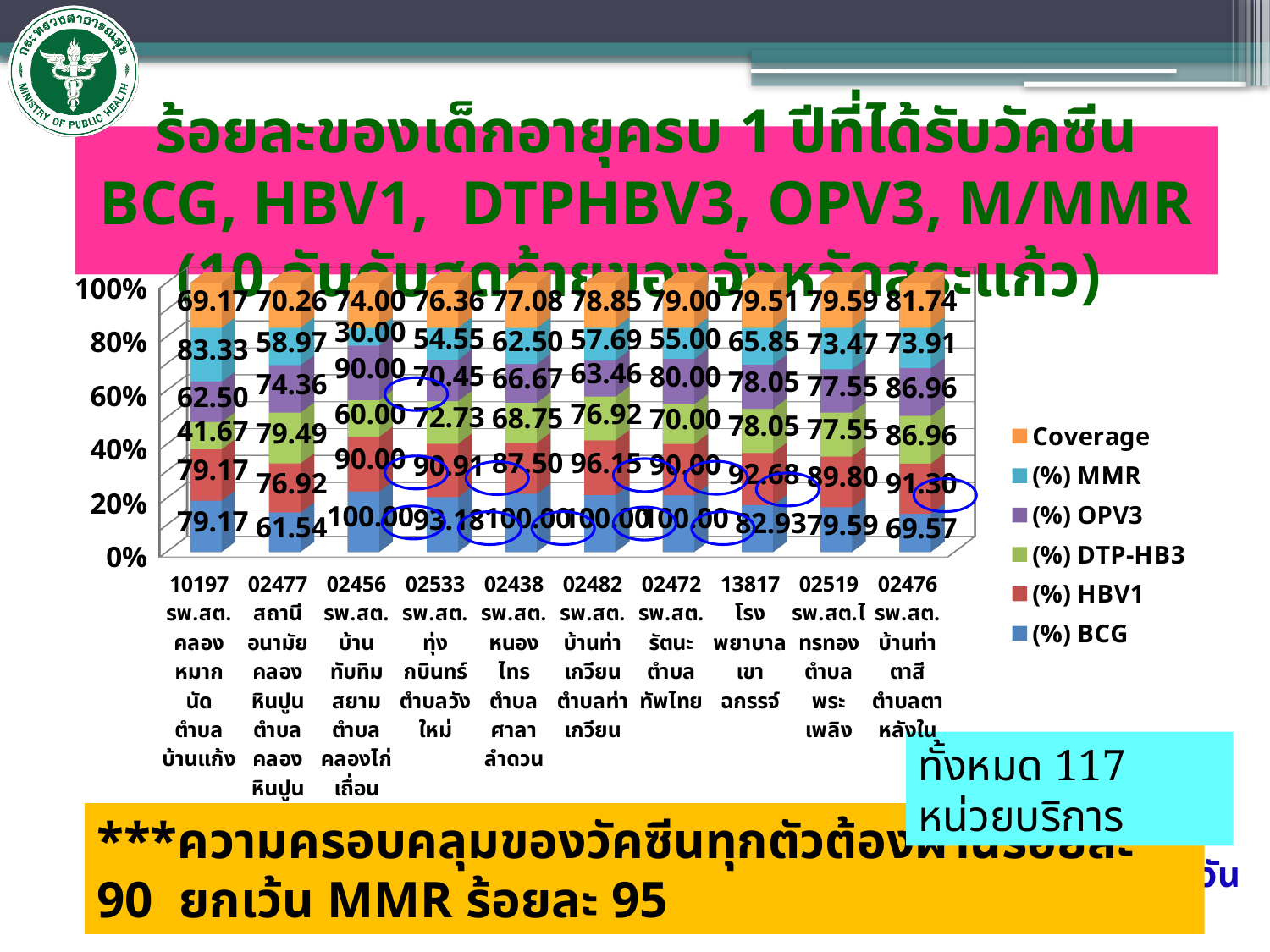
Which unit has the lowest (%) MMR value? 02456 Do the Coverage values rise or fall from left to right along the x axis? Rise How many service units (categories) are plotted along the x axis? 10 Which unit has the highest Coverage value? 02476 How many series does the legend list? 6 What is the (%) MMR value for unit 02456? 30.00 Which has the larger (%) HBV1 value, unit 02482 or unit 02533? 02482 What is the (%) BCG value for unit 02477? 61.54 What type of chart is shown on the slide? Stacked bar chart Which unit has the lowest (%) DTP-HB3 value? 10197 What is the difference between the Coverage values of unit 02476 and unit 10197? 12.57 What is the Coverage value for unit 02476? 81.74